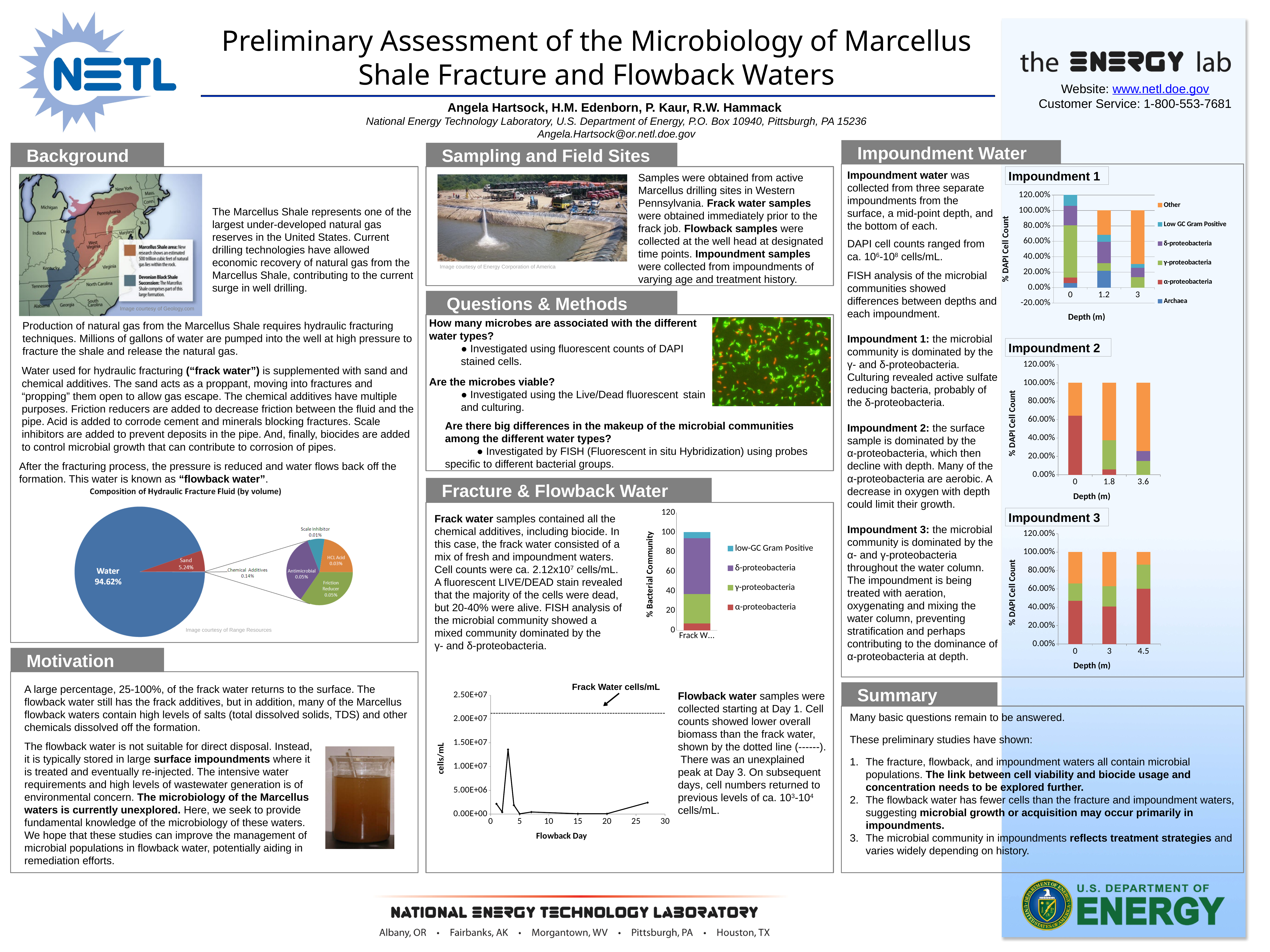
What kind of chart is the cells/mL vs Flowback Day chart? line chart In the cells/mL vs Flowback Day chart, on which Flowback Day does the cell count peak? 3 In the cells/mL vs Flowback Day chart, is the peak value at Day 3 greater or less than 1.00E+07? greater In the 'Impoundment 1' chart, how many series does the legend list? 6 In the 'Composition of Hydraulic Fracture Fluid (by volume)' pie chart, what share is Water? 94.62% What kind of chart is 'Composition of Hydraulic Fracture Fluid (by volume)'? pie chart In the 'Composition of Hydraulic Fracture Fluid (by volume)' chart, which component is the largest slice? Water In the 'Composition of Hydraulic Fracture Fluid (by volume)' pie chart, what share is Sand? 5.24% In the 'Composition of Hydraulic Fracture Fluid (by volume)' pie chart, what share is Chemical Additives? 0.14% In the '% Bacterial Community' chart for Frack Water in the Fracture & Flowback Water section, how many series does the legend list? 4 In the 'Impoundment 2' chart, how many depth categories are shown on the x axis? 3 In the 'Impoundment 2' chart, is the α-proteobacteria value at depth 0 greater or less than 40.00%? greater